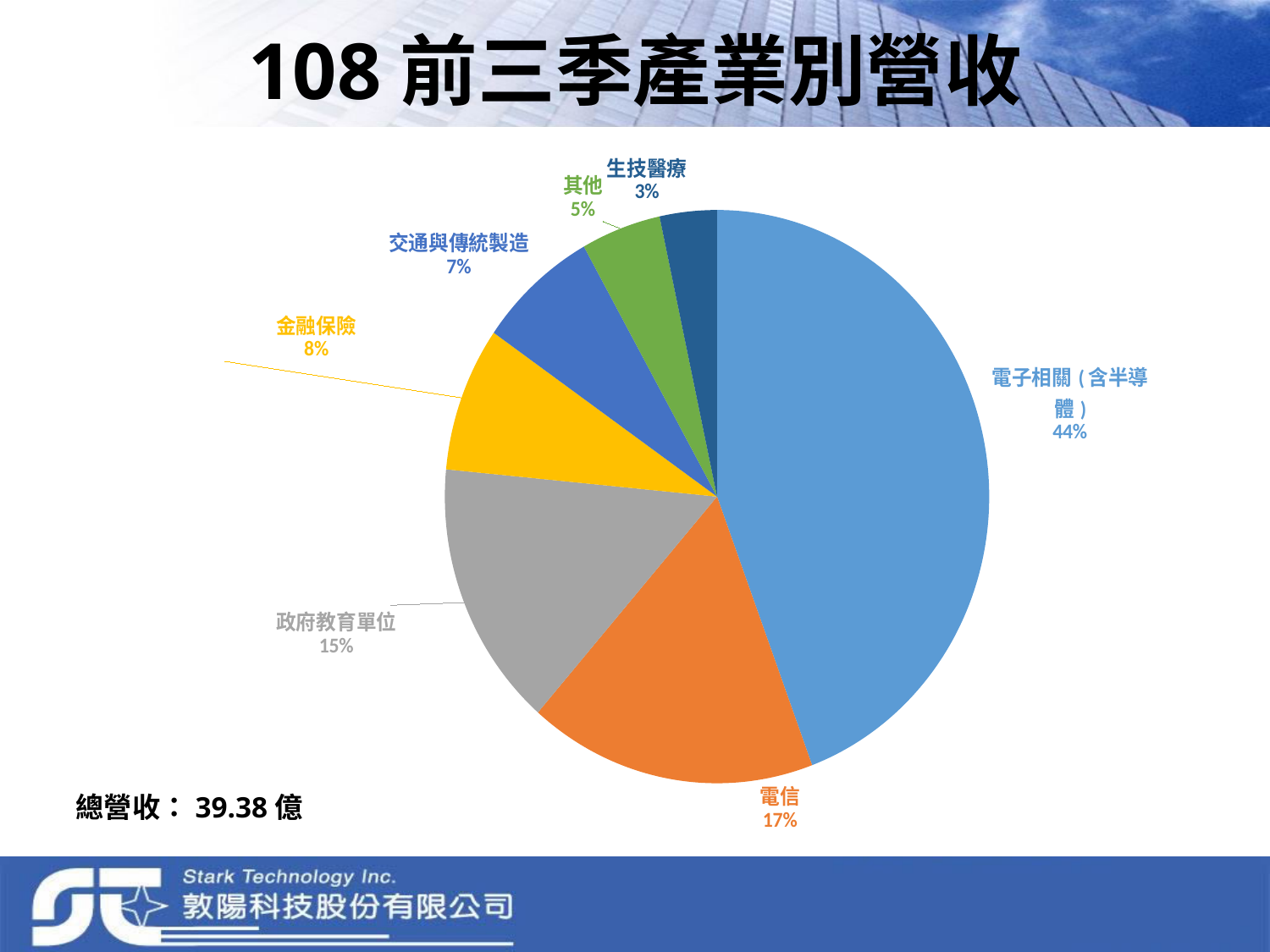
What is the percentage shown for 電信? 17% What is the difference in percentage points between 電信 and 政府教育單位? 2 What is the title of the chart on the slide? 108 前三季產業別營收 What is the percentage shown for 交通與傳統製造? 7% What is the percentage shown for 政府教育單位? 15% Which category has the largest slice of the pie? 電子相關（含半導體） What type of chart is shown on the slide? Pie chart Which is larger, the share for 其他 or the share for 生技醫療? 其他 How many categories are shown in the pie chart? 7 What share of the pie does 電子相關（含半導體） hold? 44% Which category has the smallest slice of the pie? 生技醫療 What is the percentage shown for 金融保險? 8%